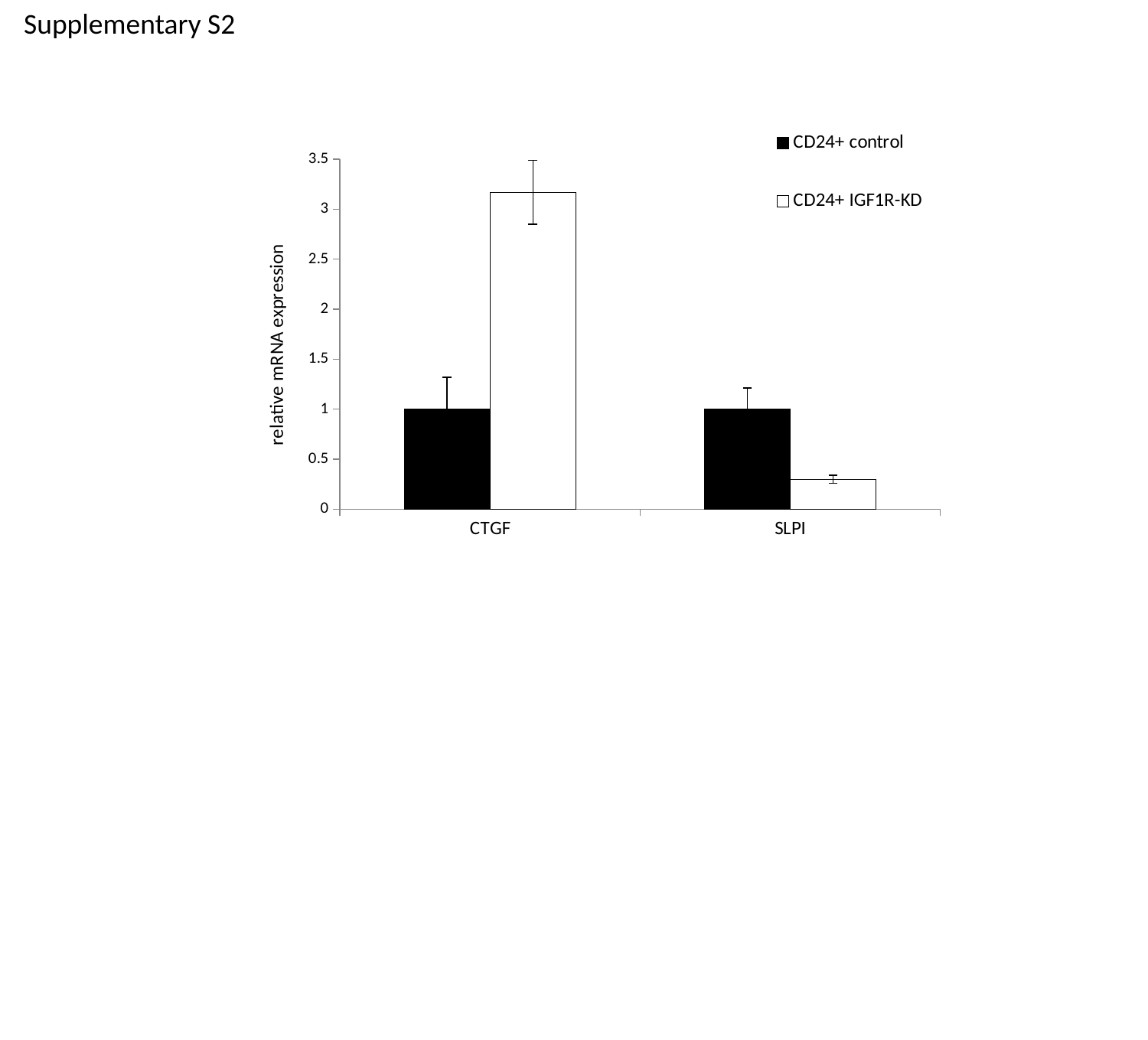
For CTGF, which series has the larger value, CD24+ control or CD24+ IGF1R-KD? CD24+ IGF1R-KD Which category has the highest value for CD24+ IGF1R-KD? CTGF What is the relative mRNA expression for CD24+ control in SLPI? 1 What is the relative mRNA expression for CD24+ control in CTGF? 1 What is the label on the y axis? relative mRNA expression How many series does the legend list? 2 Is the value for CD24+ IGF1R-KD in SLPI greater or less than 0.5? less How many categories are shown on the x axis? 2 What colour are the CD24+ control bars? black What kind of chart is shown on the slide? bar chart For SLPI, which series has the larger value, CD24+ control or CD24+ IGF1R-KD? CD24+ control Is the value for CD24+ IGF1R-KD in CTGF greater or less than 3? greater